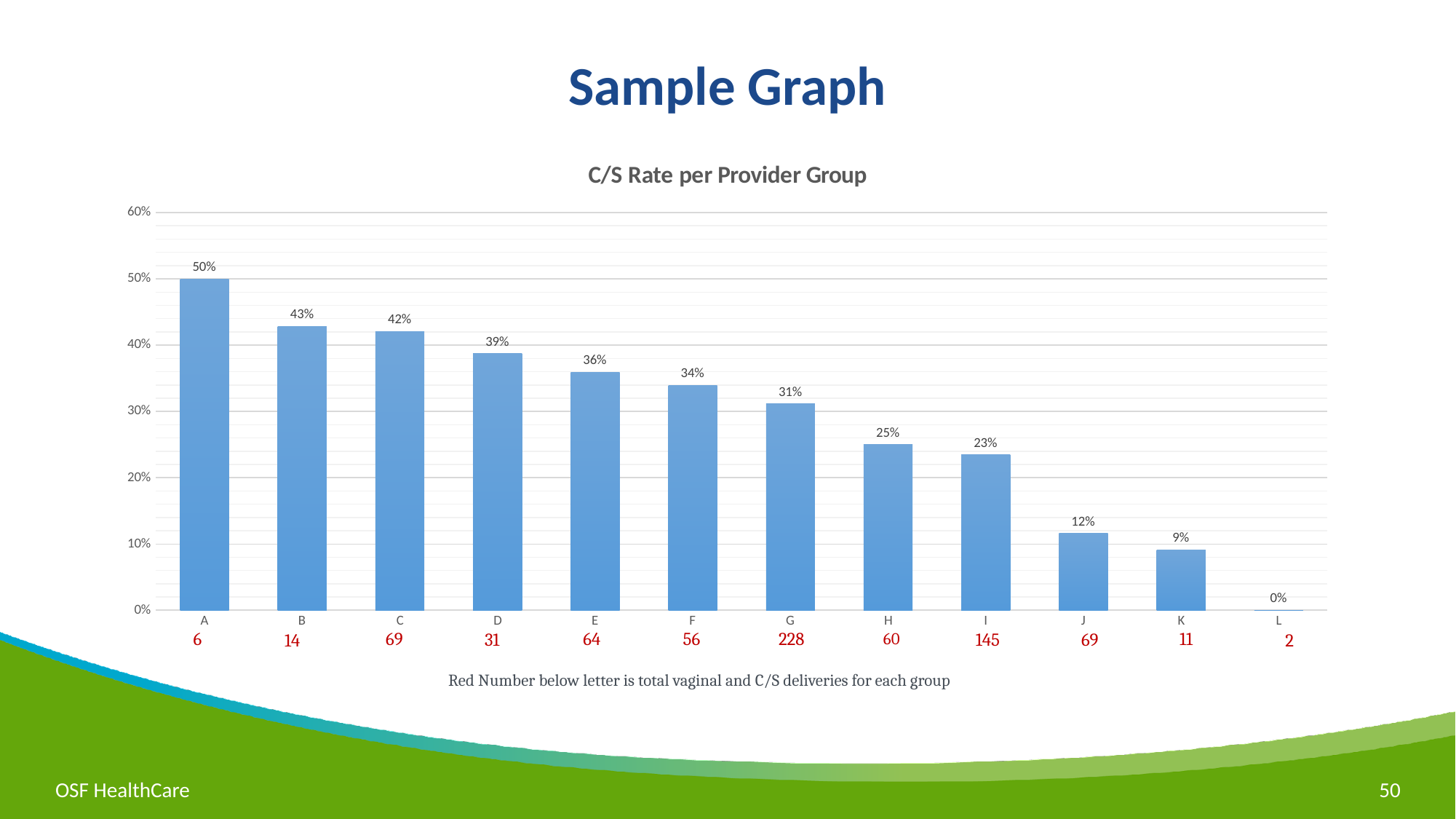
What is the C/S rate for provider group K? 9% What is the difference in C/S rate between provider group A and provider group D? 11% Which provider group has the highest C/S rate? A Which provider group has a higher C/S rate, E or H? E What kind of chart is shown on the slide? Bar chart What is the title of the chart? C/S Rate per Provider Group What is the C/S rate for provider group G? 31% Do the C/S rates rise or fall from group A to group L along the x axis? Fall What is the red number shown below provider group G? 228 What is the C/S rate for provider group A? 50% How many provider groups are shown on the chart? 12 Which provider group has the lowest C/S rate? L